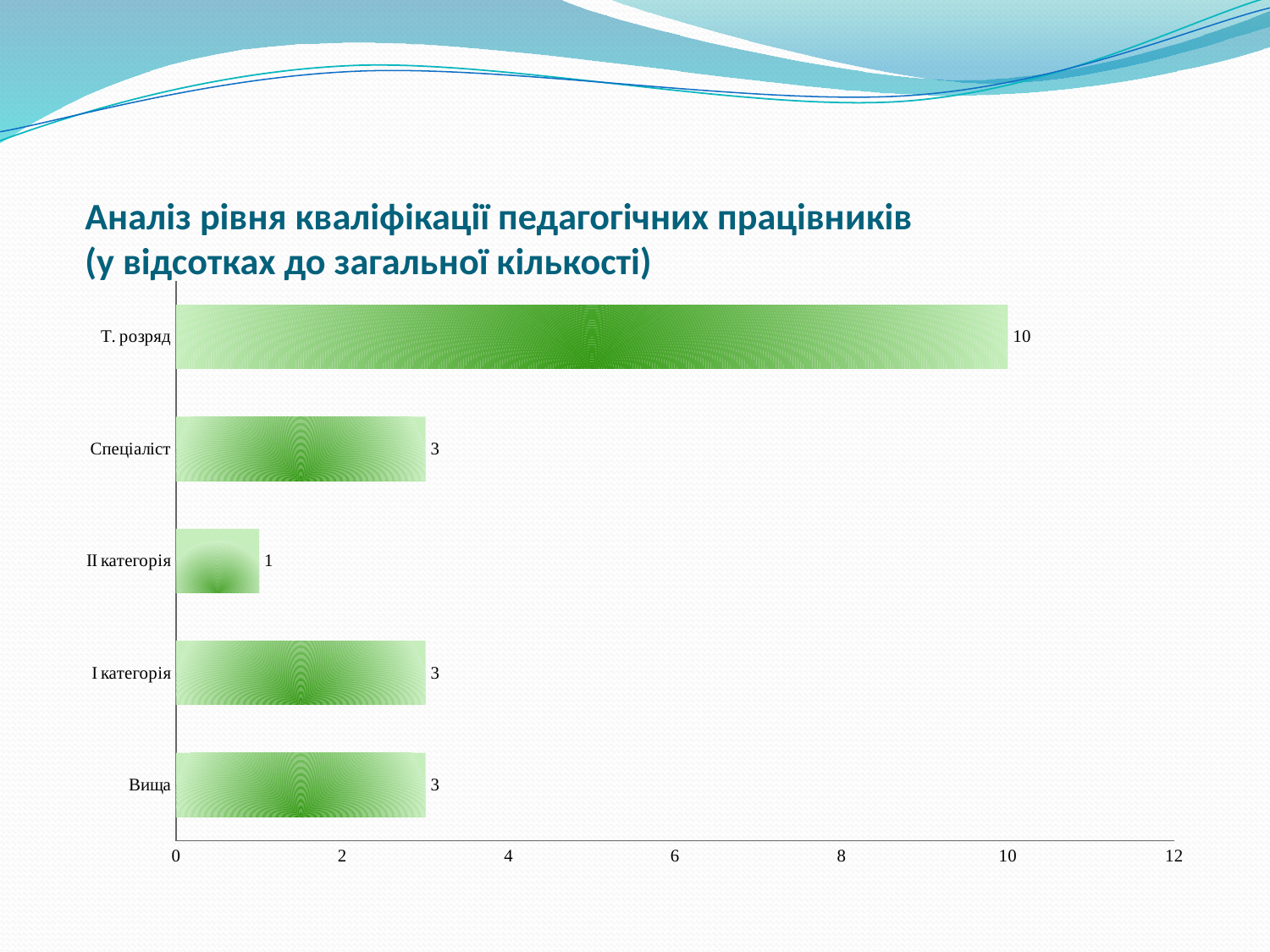
What is the value for Спеціаліст? 3 Is the value for Т. розряд greater or less than 8? greater What is the value for ІІ категорія? 1 What is the maximum value shown on the horizontal axis? 12 What is the value for Т. розряд? 10 What is the difference between the values for І категорія and ІІ категорія? 2 Which category has the lowest value? ІІ категорія What kind of chart is shown on the slide? bar chart Which category has the highest value? Т. розряд How many categories are shown in the chart? 5 Which is larger, the value for Спеціаліст or the value for ІІ категорія? Спеціаліст What is the difference between the values for Т. розряд and Вища? 7